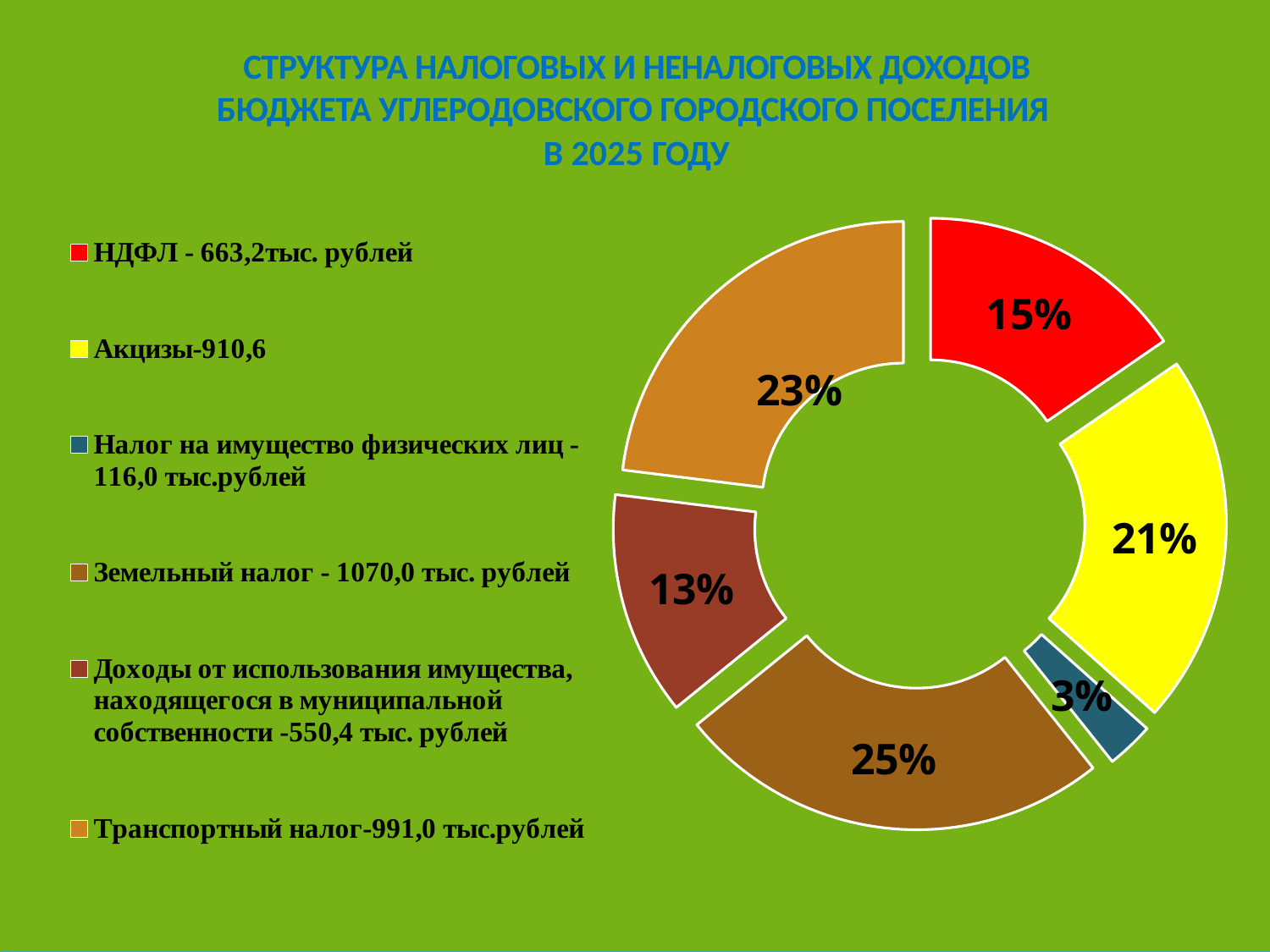
What is the difference in percentage points between Земельный налог and Доходы от использования имущества? 12 Which has a larger share: Акцизы or НДФЛ? Акцизы Which category has the smallest share of the chart? Налог на имущество физических лиц How many categories are shown in the chart? 6 What share of the chart does НДФЛ account for? 15% What kind of chart is shown on the slide? Doughnut (pie) chart What share does Земельный налог have in the chart? 25% What percentage is shown for Акцизы? 21% What share does Налог на имущество физических лиц have? 3% What colour is the slice for Акцизы? Yellow Which category has the largest share of the chart? Земельный налог What percentage is shown for Транспортный налог? 23%